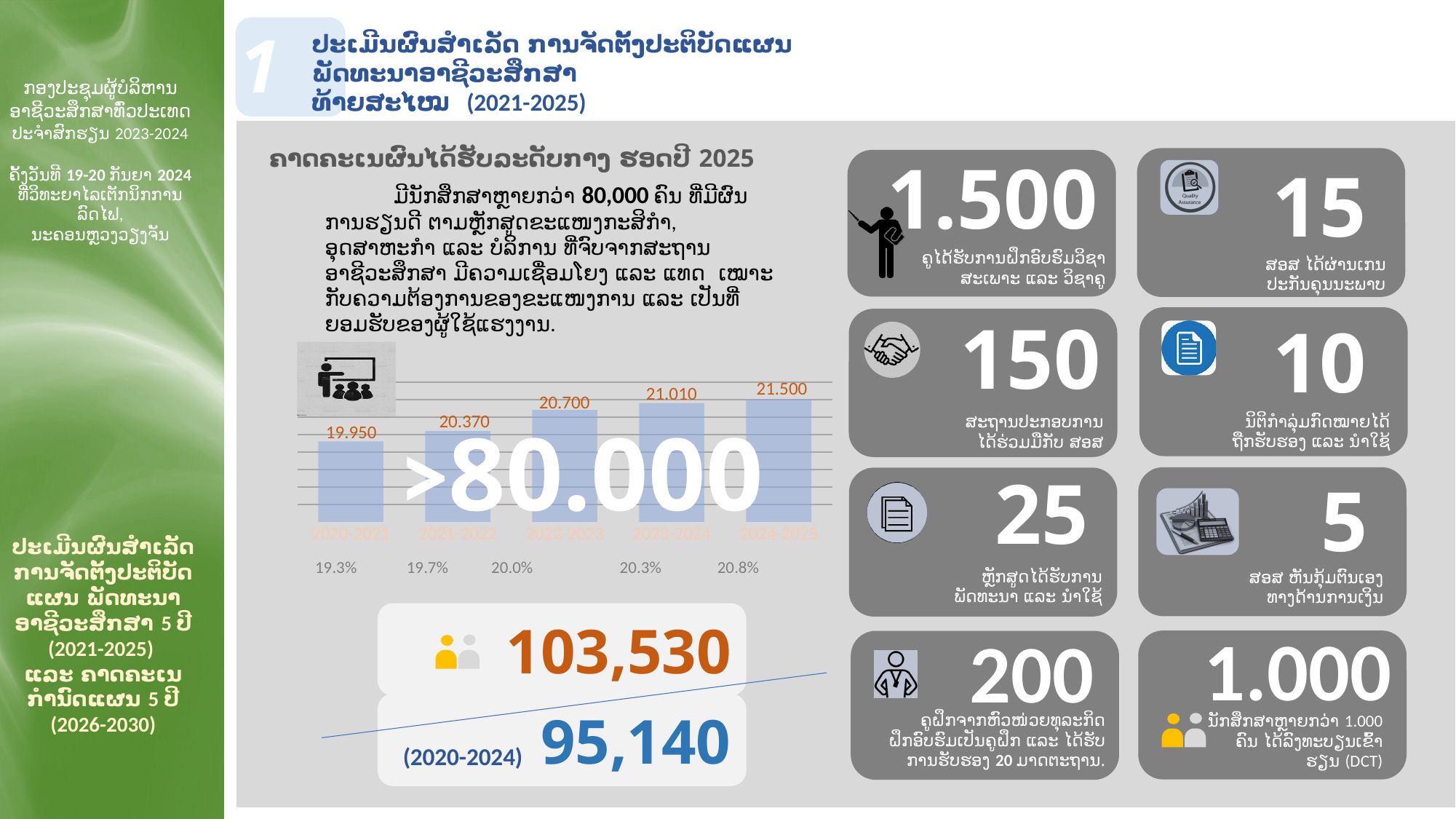
In the bar chart, which period has the highest value? 2024-2025 In the bar chart, what is the difference between the values for 2024-2025 and 2020-2021? 1.550 How many bars are in the bar chart? 5 In the bar chart, do the values rise or fall from 2020-2021 to 2024-2025? rise In the bar chart, which is larger, the value for 2021-2022 or the value for 2023-2024? 2023-2024 In the bar chart, what is the value for 2022-2023? 20.700 What type of chart is shown on the left of the slide? bar chart What large number is printed over the bars of the bar chart? >80.000 In the bar chart, what is the value for 2023-2024? 21.010 In the bar chart, what is the value for 2020-2021? 19.950 In the bar chart, what is the value for 2024-2025? 21.500 In the bar chart, which period has the lowest value? 2020-2021